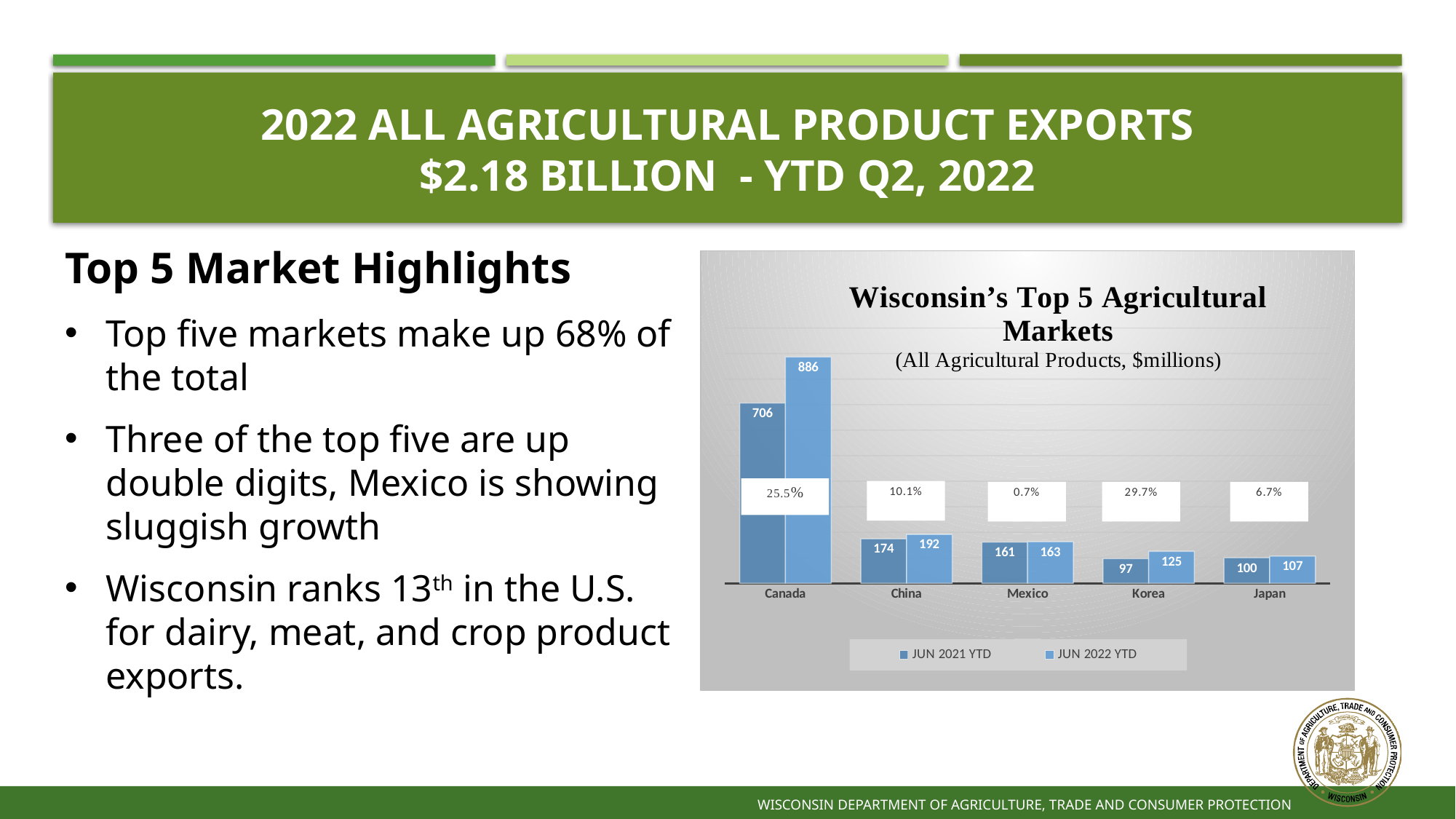
Which is larger, the JUN 2022 YTD value for Korea or for Japan? Korea How many series does the legend list? 2 Which market has the highest JUN 2022 YTD value? Canada What is the JUN 2022 YTD value for Canada? 886 What is the JUN 2022 YTD value for Japan? 107 What is the difference between the JUN 2022 YTD values for China and Mexico? 29 How many markets are shown on the x axis? 5 What percentage change is shown for Korea? 29.7% What is the difference between the JUN 2022 YTD and JUN 2021 YTD values for Canada? 180 What kind of chart is shown? Bar chart What is the JUN 2021 YTD value for Korea? 97 Which market has the lowest JUN 2021 YTD value? Korea